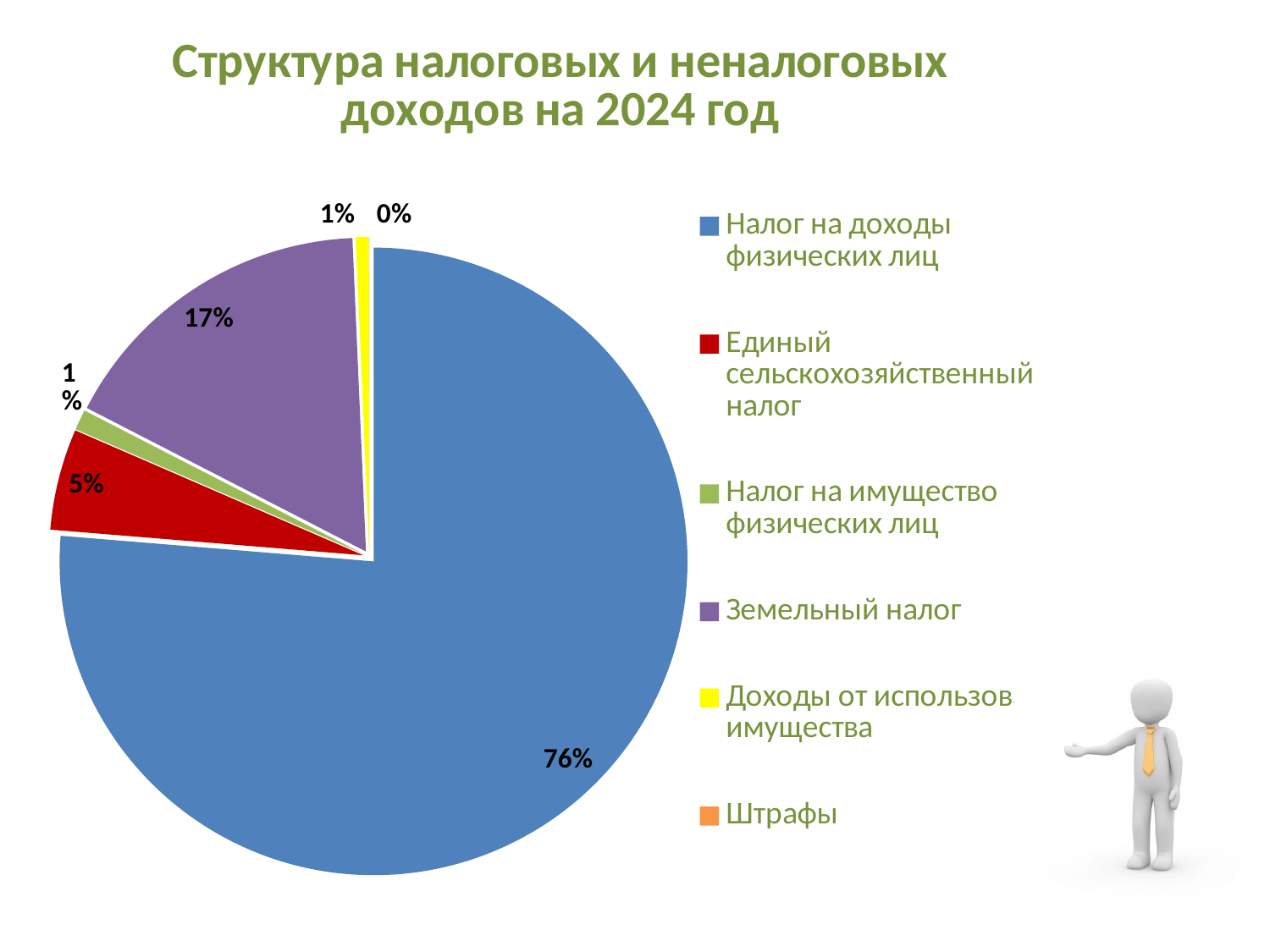
What share of the pie does Налог на доходы физических лиц have? 76% Which category has the largest share of the pie? Налог на доходы физических лиц What share of the pie does Штрафы have? 0% Which has a larger share: Земельный налог or Единый сельскохозяйственный налог? Земельный налог What is the difference in percentage points between the shares of Налог на доходы физических лиц and Земельный налог? 59 percentage points Which category has the smallest share of the pie? Штрафы What share of the pie does Налог на имущество физических лиц have? 1% What share of the pie does Земельный налог have? 17% What is the title of the chart? Структура налоговых и неналоговых доходов на 2024 год What share of the pie does Единый сельскохозяйственный налог have? 5% What kind of chart is shown on the slide? Pie chart How many categories does the legend list? 6